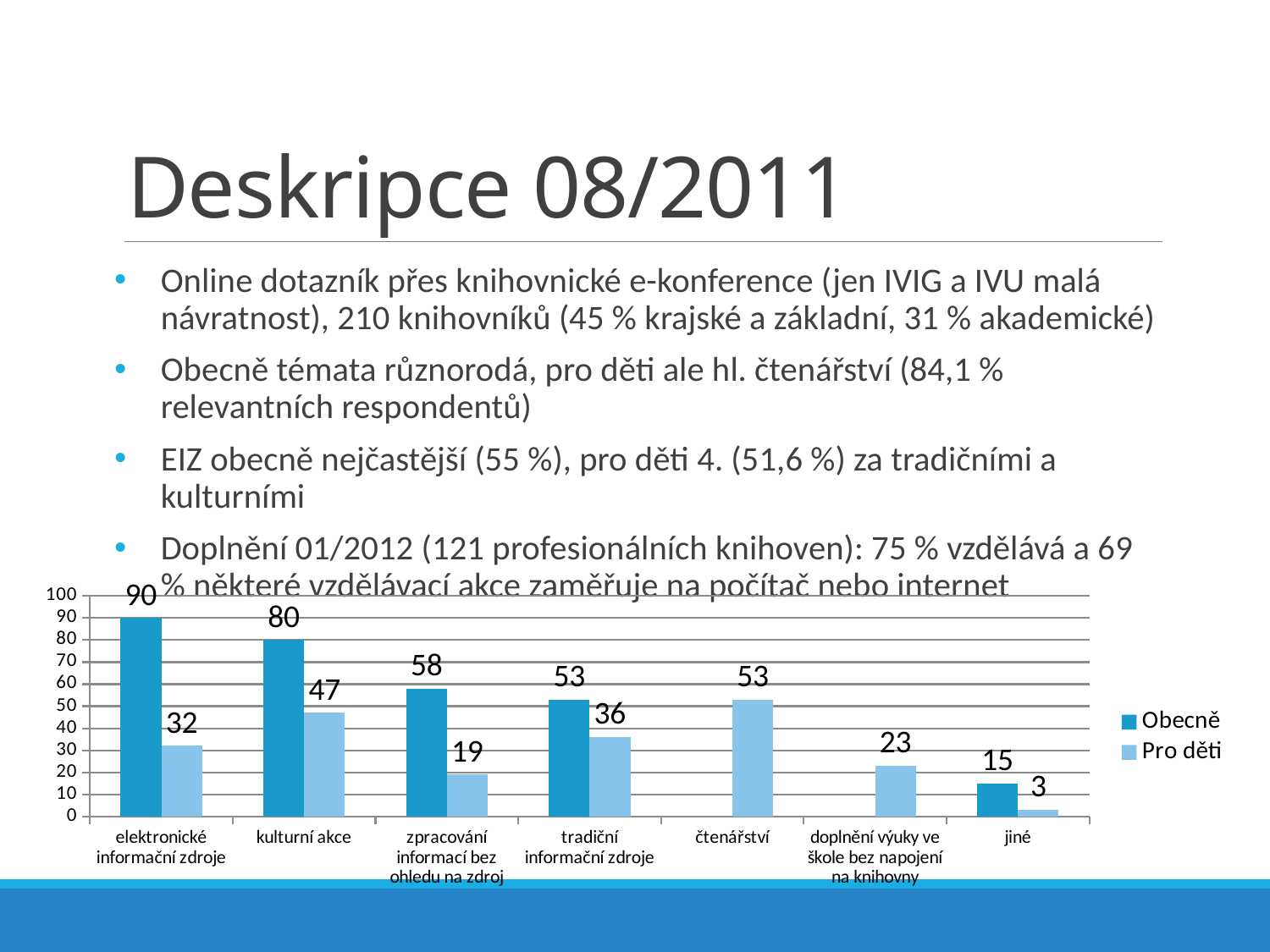
What is the value for "Obecně" for jiné? 15 How many categories are shown on the x axis of the chart? 7 What are the two series named in the chart legend? Obecně and Pro děti What is the value for "Pro děti" for kulturní akce? 47 What is the value for "Pro děti" for čtenářství? 53 How many series does the chart legend list? 2 What kind of chart is shown on the slide? bar chart What is the difference between the "Obecně" and "Pro děti" values for elektronické informační zdroje? 58 What is the value for "Obecně" for elektronické informační zdroje? 90 Which is larger for tradiční informační zdroje: the "Obecně" value or the "Pro děti" value? Obecně Which category has the highest value for "Obecně"? elektronické informační zdroje Which category has the lowest value for "Pro děti"? jiné